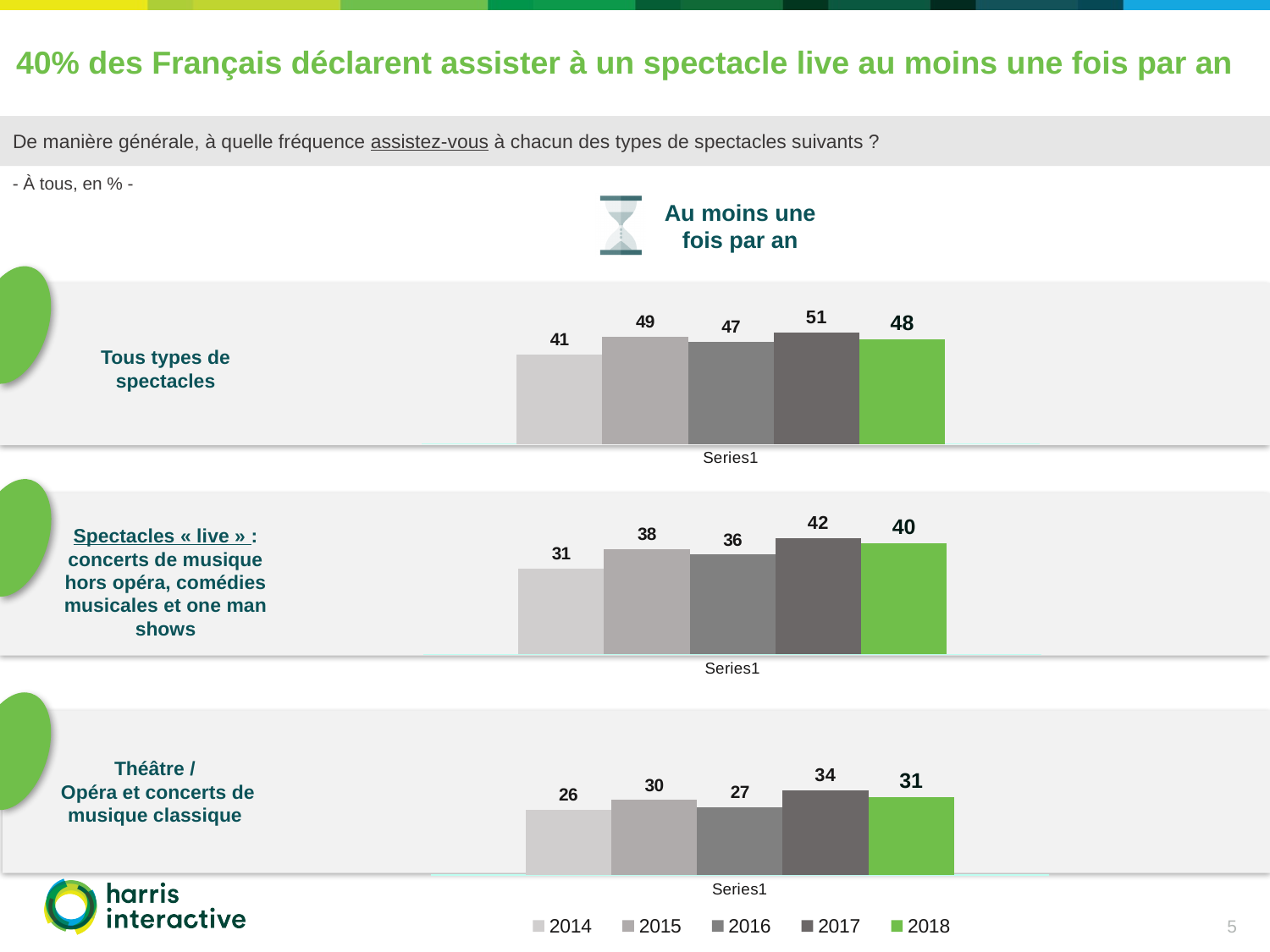
In the 'Tous types de spectacles' chart, which year has the lowest value? 2014 In the 'Spectacles « live »' chart, what is the difference between the 2017 and 2014 values? 11 How many years does the legend at the bottom of the slide list? 5 In the 'Tous types de spectacles' chart, what is the value for 2018? 48 In the 'Théâtre / Opéra et concerts de musique classique' chart, what is the value for 2017? 34 In the 'Tous types de spectacles' chart, which year has the highest value? 2017 In the 'Théâtre / Opéra et concerts de musique classique' chart, what is the difference between the 2018 and 2014 values? 5 How many bars are shown in the 'Tous types de spectacles' chart? 5 In the 'Spectacles « live »' chart, what is the value for 2014? 31 In the 'Spectacles « live »' chart, which is larger, the value for 2015 or the value for 2016? 2015 In the 'Théâtre / Opéra et concerts de musique classique' chart, which year has the lowest value? 2014 What type of chart is used for 'Spectacles « live »'? Bar chart